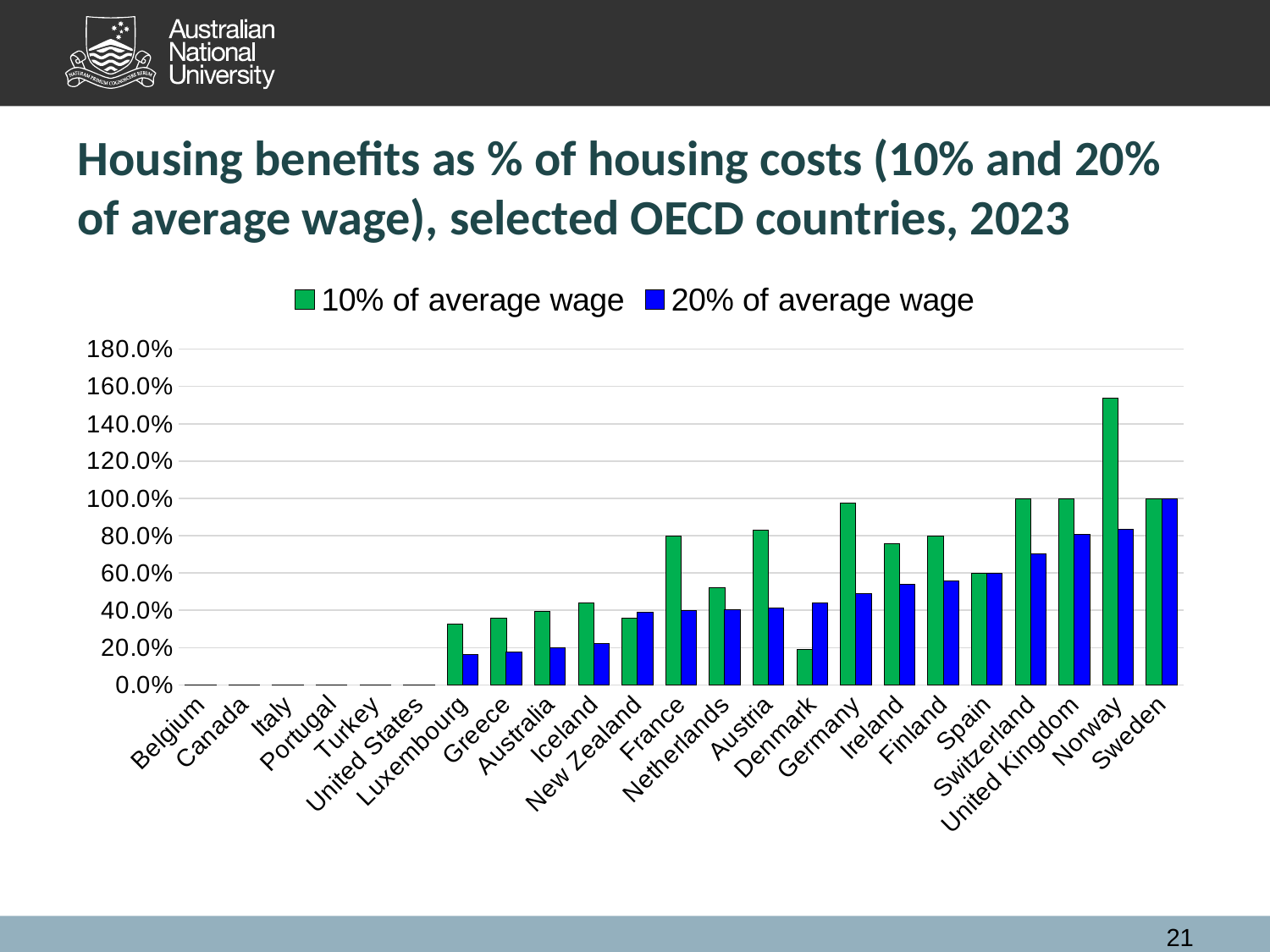
Which is larger: the 10% of average wage value for France or for Greece? France How many countries are shown on the x axis? 23 Is the value for Luxembourg at 20% of average wage greater or less than 20%? less Do the values for 10% of average wage generally rise or fall from left to right across the countries? rise What kind of chart is shown on the slide? bar chart Is the value for Norway at 10% of average wage greater or less than 140%? greater What colour represents the 20% of average wage series? blue Which country has the highest value for 10% of average wage? Norway Is the value for Austria at 10% of average wage greater or less than 60%? greater For Denmark, which series has the larger value: 10% of average wage or 20% of average wage? 20% of average wage How many series does the legend list? 2